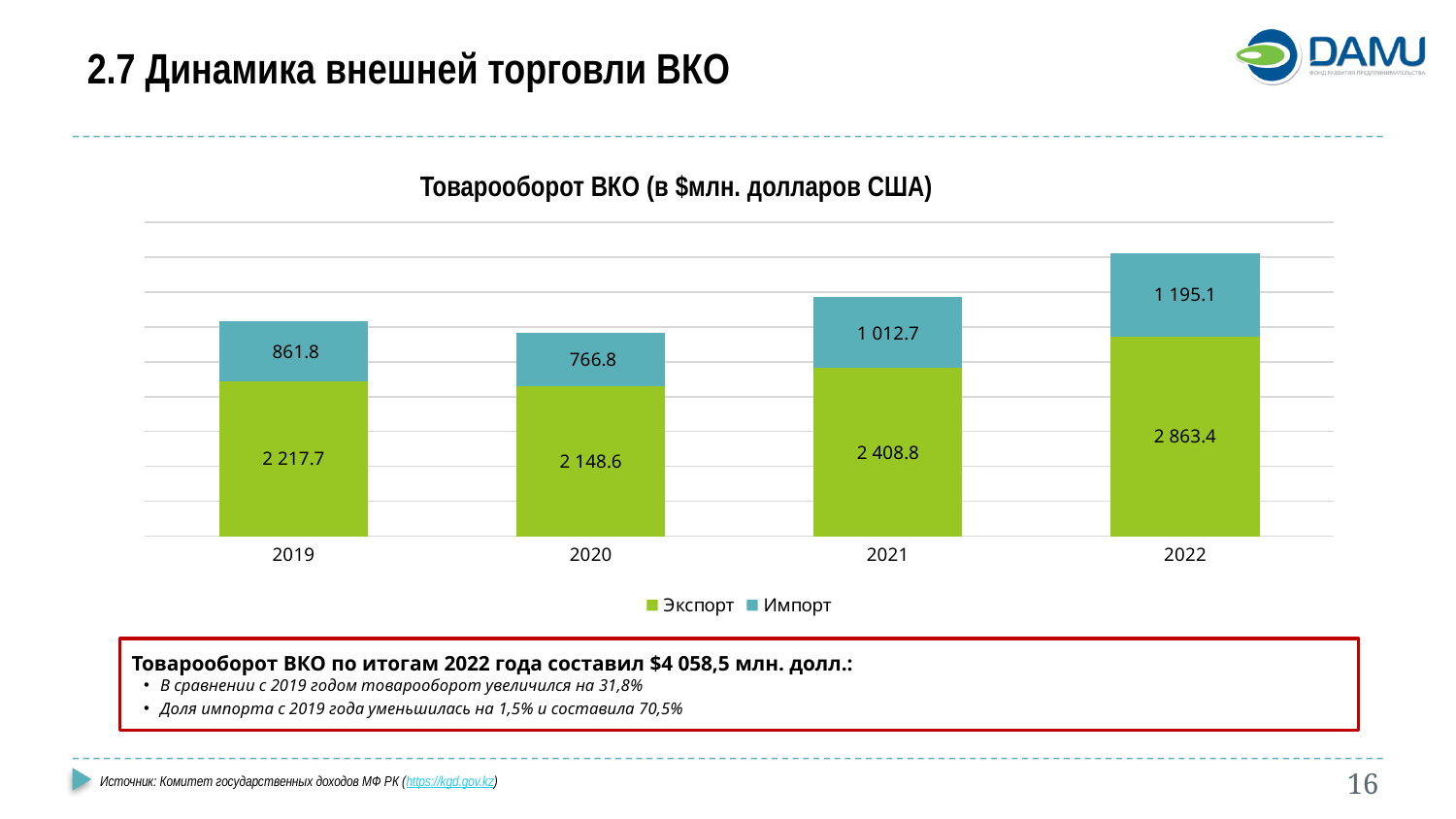
Which series is shown in green in the chart? Экспорт What is the import value for 2020? 766.8 What is the total of the stacked bar for 2022? 4 058.5 What kind of chart is shown on the slide? Stacked bar chart What is the import value for 2019? 861.8 How many series does the legend list? 2 Which year has the lowest import value? 2020 How many years are shown on the x axis of the chart? 4 Which year has the highest export value? 2022 Which is larger: the export value for 2019 or the export value for 2020? 2019 What is the export value for 2022 in the chart 'Товарооборот ВКО (в $млн. долларов США)'? 2 863.4 What is the difference between the import values for 2022 and 2021? 182.4